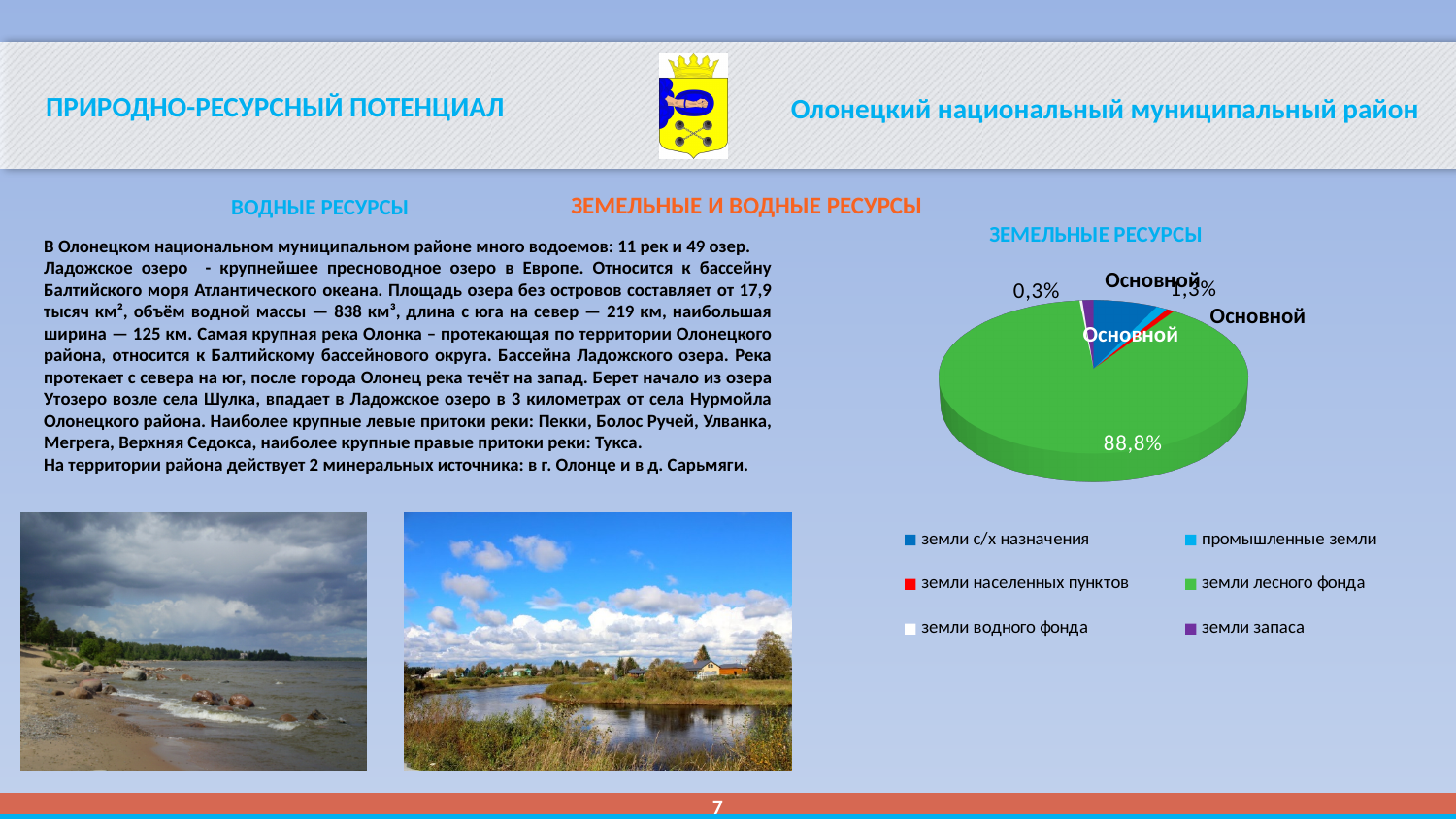
In the ЗЕМЕЛЬНЫЕ РЕСУРСЫ pie chart, which category has the largest slice? земли лесного фонда In the ЗЕМЕЛЬНЫЕ РЕСУРСЫ pie chart, what share is shown for земли лесного фонда? 88,8% How many categories does the legend of the ЗЕМЕЛЬНЫЕ РЕСУРСЫ pie chart list? 6 What is the largest percentage printed on the ЗЕМЕЛЬНЫЕ РЕСУРСЫ pie chart? 88,8% In the ЗЕМЕЛЬНЫЕ РЕСУРСЫ pie chart, how much larger is the 88,8% slice than the 1,3% slice? 87,5% What is the smallest percentage printed on the ЗЕМЕЛЬНЫЕ РЕСУРСЫ pie chart? 0,3% In the ЗЕМЕЛЬНЫЕ РЕСУРСЫ pie chart, which is larger: the slice labelled 1,3% or the slice labelled 0,3%? 1,3% In the ЗЕМЕЛЬНЫЕ РЕСУРСЫ pie chart, is the share for земли лесного фонда greater or less than 50%? greater What is the title of the chart on the right side of the slide? ЗЕМЕЛЬНЫЕ РЕСУРСЫ What kind of chart is shown under the heading ЗЕМЕЛЬНЫЕ РЕСУРСЫ? Pie chart What colour represents земли лесного фонда in the ЗЕМЕЛЬНЫЕ РЕСУРСЫ pie chart legend? Green